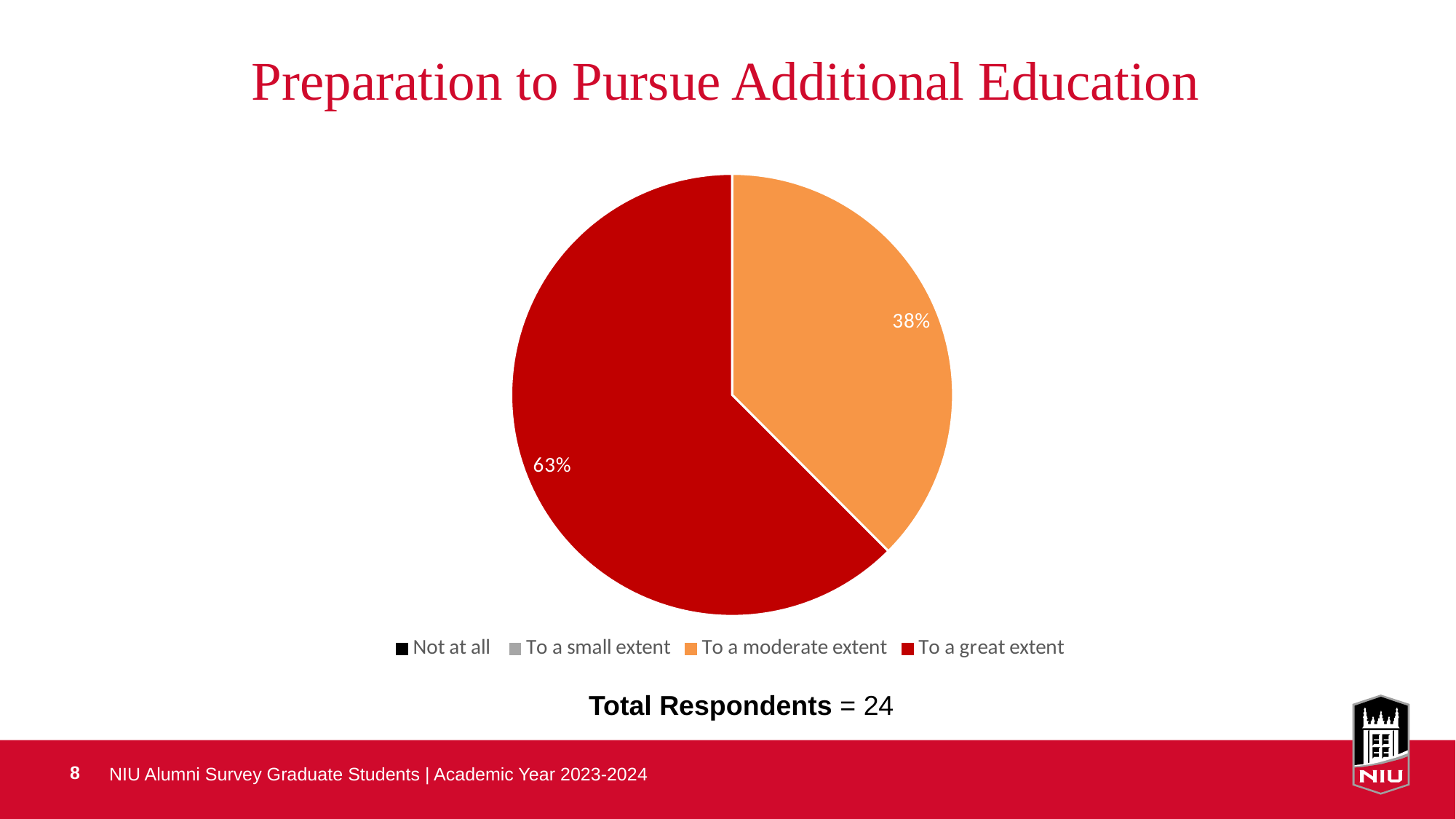
Which response category has the largest share of the pie? To a great extent Which of the two visible slices is larger, "To a moderate extent" or "To a great extent"? To a great extent What percentage of respondents answered "To a great extent"? 63% How many slices are visible in the pie chart? 2 How many response categories does the legend list? 4 What colour represents "To a great extent" in the chart? red What is the difference in percentage points between "To a great extent" and "To a moderate extent"? 25 What kind of chart is shown on the slide? pie chart What percentage of respondents answered "To a moderate extent"? 38% What is the title of the slide containing the chart? Preparation to Pursue Additional Education What is the total number of respondents shown on the slide? 24